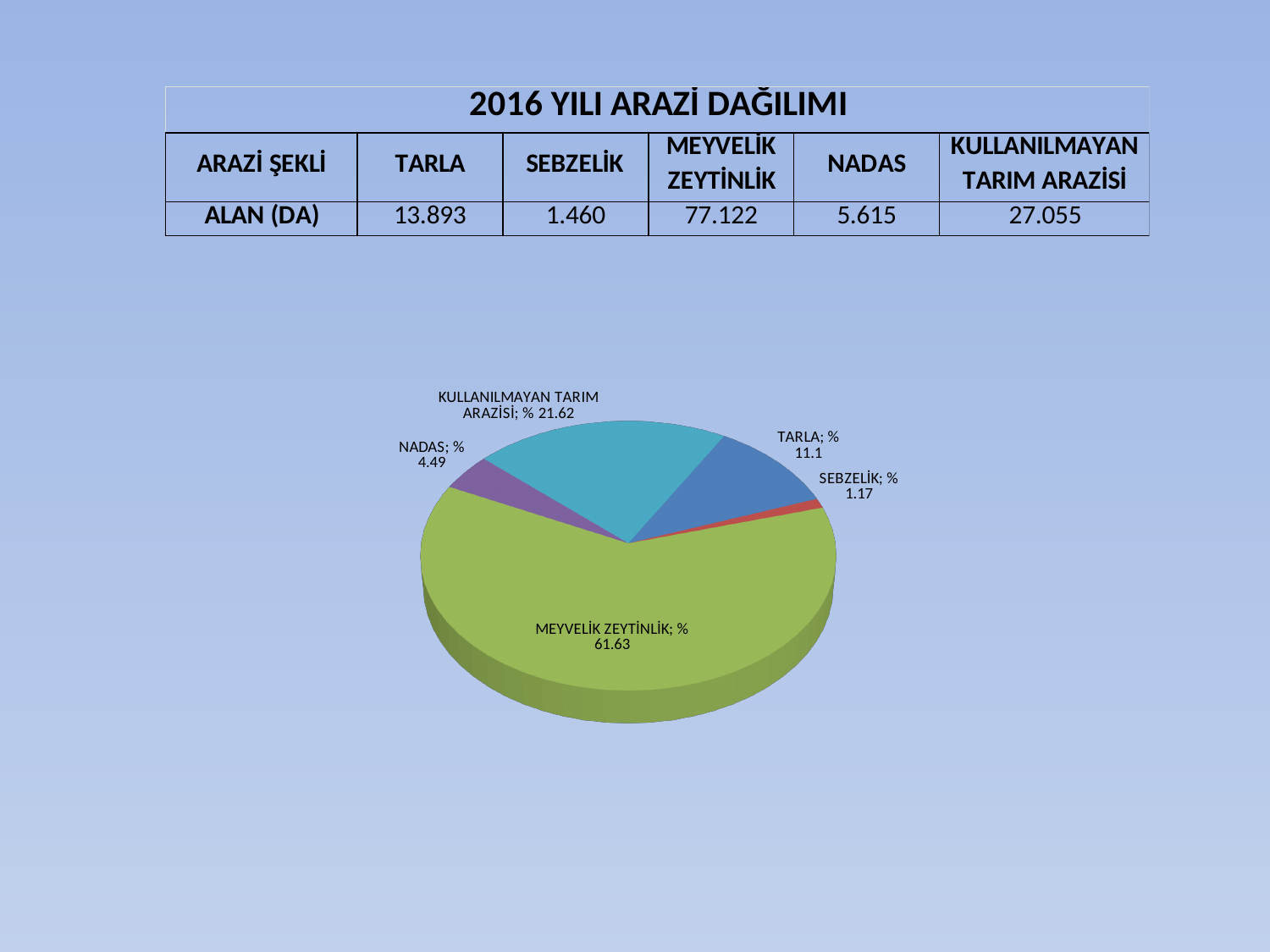
What share of the pie does MEYVELİK ZEYTİNLİK have? % 61.63 Which slice is larger in the pie chart, TARLA or NADAS? TARLA What share of the pie does SEBZELİK have? % 1.17 Which slice of the pie chart is the largest? MEYVELİK ZEYTİNLİK What is the difference in percentage points between the KULLANILMAYAN TARIM ARAZİSİ slice and the TARLA slice? 10.52 What share of the pie does TARLA have? % 11.1 How many slices does the pie chart have? 5 What kind of chart is shown on the slide? pie chart Which slice of the pie chart is the smallest? SEBZELİK What colour is the MEYVELİK ZEYTİNLİK slice in the pie chart? green